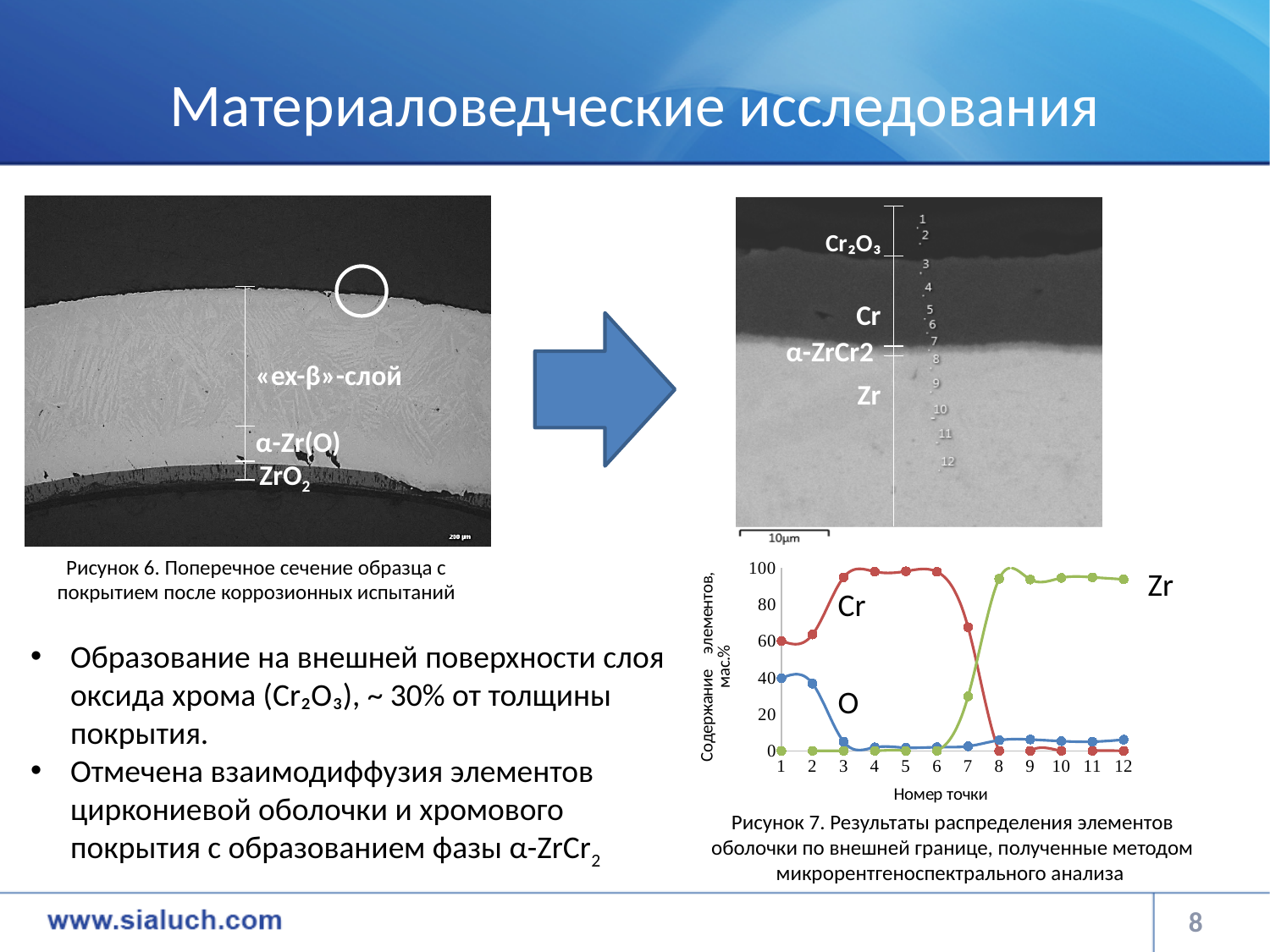
Is the Zr value at point 1 greater or less than 20? less Is the Cr value at point 12 greater or less than 20? less How many points (Номер точки) are plotted along the x axis of the chart? 12 How many element series are plotted in the chart? 3 At point 10, which series has the higher value, Zr or Cr? Zr Is the Cr value at point 4 greater or less than 80? greater What kind of chart is shown in Рисунок 7? line chart At point 1, which series has the higher value, Cr or O? Cr What is the x-axis title of the chart? Номер точки Does the Zr series rise or fall from point 6 to point 9? rise Which elements are plotted as series in the chart? Cr, O, Zr